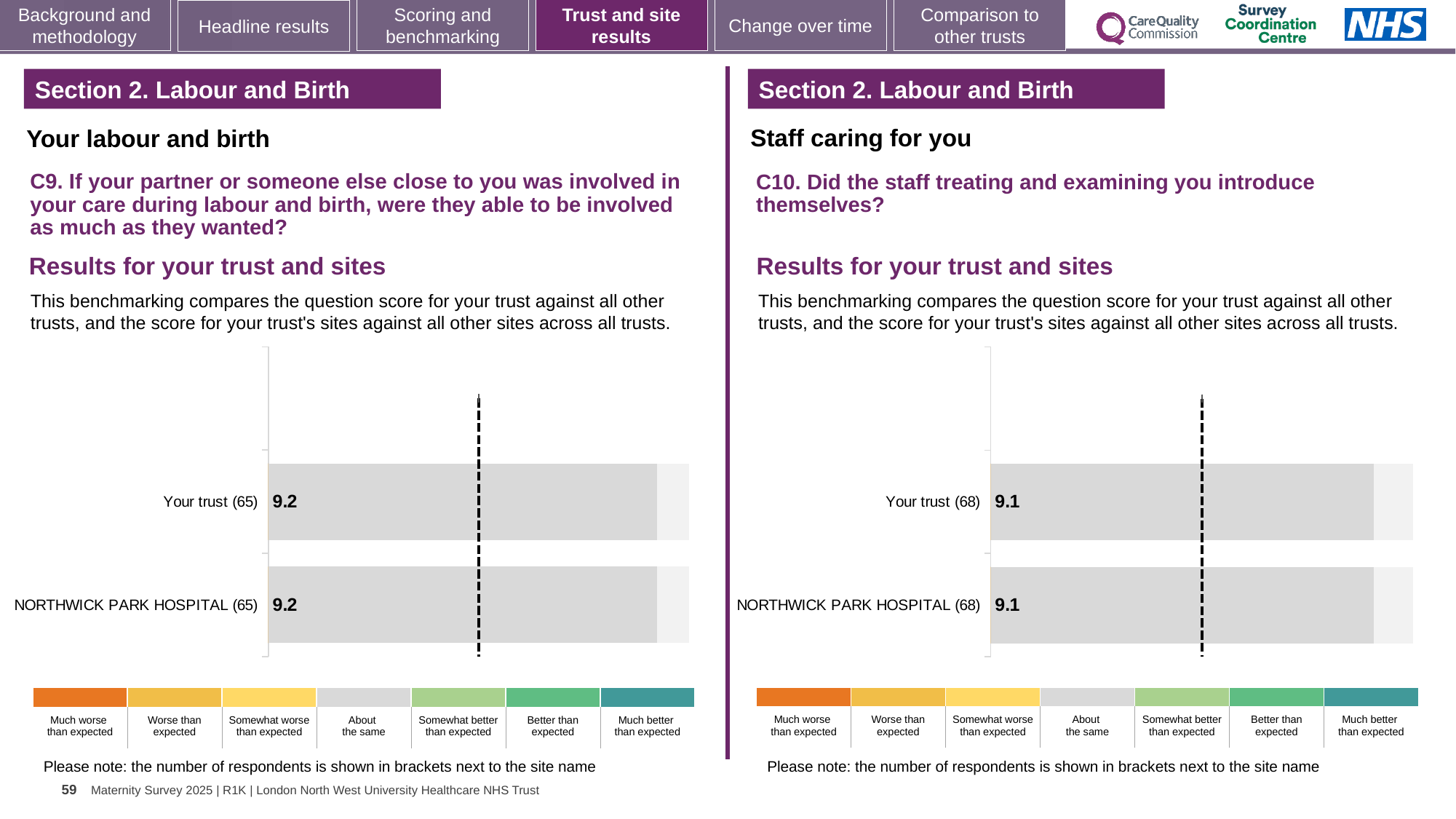
In the C9 chart on the left, how many respondents are shown in brackets for Your trust? 65 In the C9 chart on the left, what is the difference between the score for Your trust and the score for NORTHWICK PARK HOSPITAL? 0 What kind of chart is used for the C10 results on the right? bar chart Is the score for Your trust in the C10 chart on the right larger or smaller than the score for Your trust in the C9 chart on the left? smaller In the C10 chart on the right, what is the score for NORTHWICK PARK HOSPITAL? 9.1 How many bars are plotted in the C9 chart on the left? 2 Which benchmark category does the grey colour of the bars in the C10 chart on the right correspond to in the colour key? About the same In the C9 chart on the left, what is the score for Your trust? 9.2 In the C10 chart on the right, what is the score for Your trust? 9.1 In the C9 chart on the left, what is the score for NORTHWICK PARK HOSPITAL? 9.2 In the C10 chart on the right, how many respondents are shown in brackets for NORTHWICK PARK HOSPITAL? 68 How many benchmark categories does the colour key below the C9 chart on the left list? 7